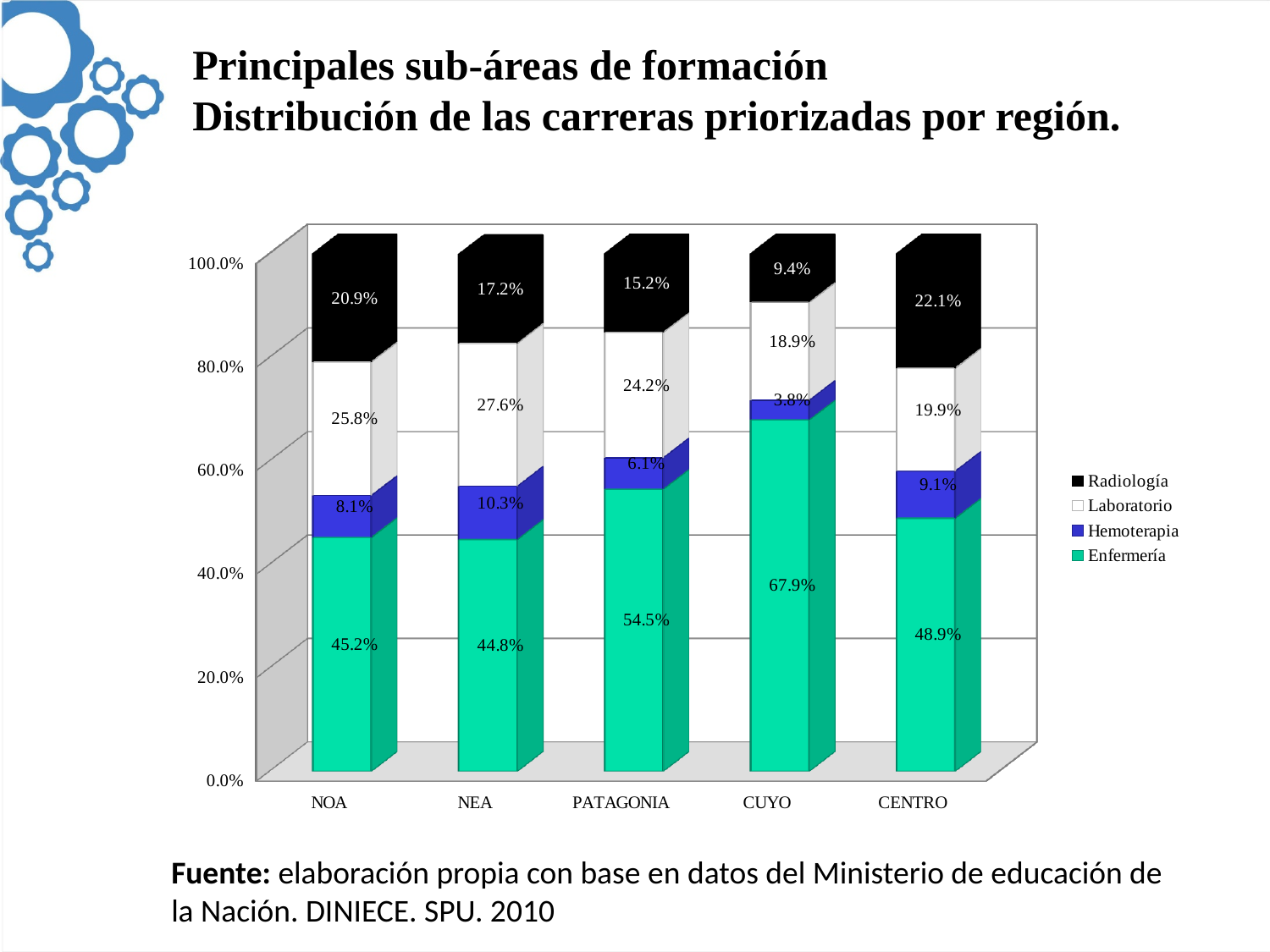
Which region has the lowest Radiología value? CUYO How many series does the legend list? 4 What is the Radiología value for CENTRO? 22.1% What is the Laboratorio value for NEA? 27.6% Which series is shown in black in the legend? Radiología What is the Enfermería value for CUYO? 67.9% What kind of chart is shown on the slide? Stacked bar chart Which is larger, the Laboratorio value for NOA or the Laboratorio value for CENTRO? NOA What is the difference between the Enfermería values for CUYO and NEA? 23.1% What is the Hemoterapia value for PATAGONIA? 6.1% Which region has the highest Enfermería value? CUYO How many regions are shown on the x axis? 5